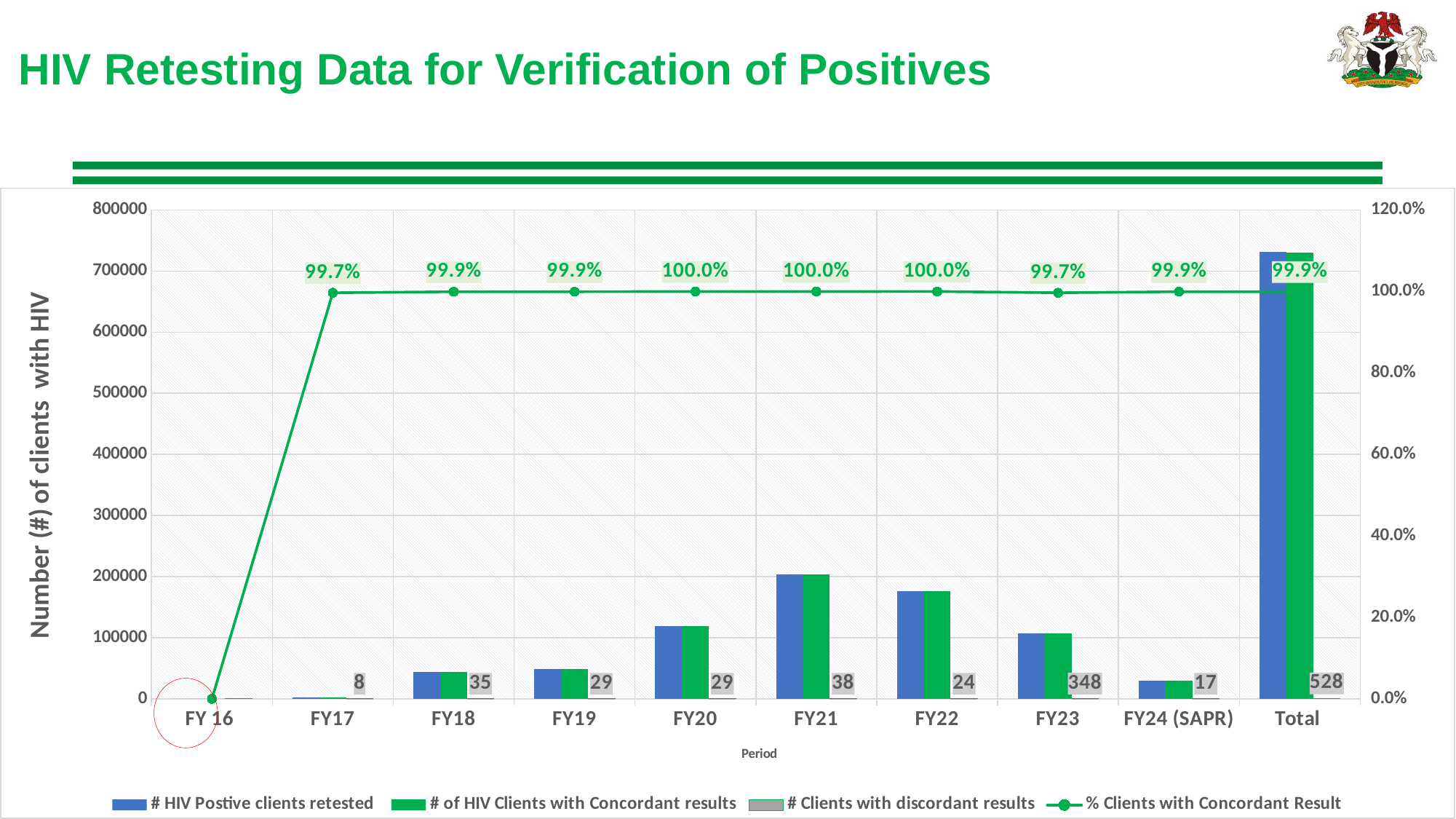
What is the % Clients with Concordant Result for FY17? 99.7% How many periods are shown on the x axis? 10 How many clients with discordant results are shown for FY23? 348 What is the % Clients with Concordant Result for FY21? 100.0% Among the periods with a labelled discordant count, which has the lowest number of clients with discordant results? FY17 Which period has more HIV positive clients retested, FY21 or FY22? FY21 Among the fiscal years FY17 through FY24 (SAPR), which period has the highest number of clients with discordant results? FY23 What is the number of clients with discordant results for the Total period? 528 How many series does the legend list? 4 Is the number of HIV positive clients retested in FY21 greater or less than 100000? greater What kind of chart is shown on the slide? Bar chart with a line What is the difference between the number of clients with discordant results in FY23 and in FY22? 324